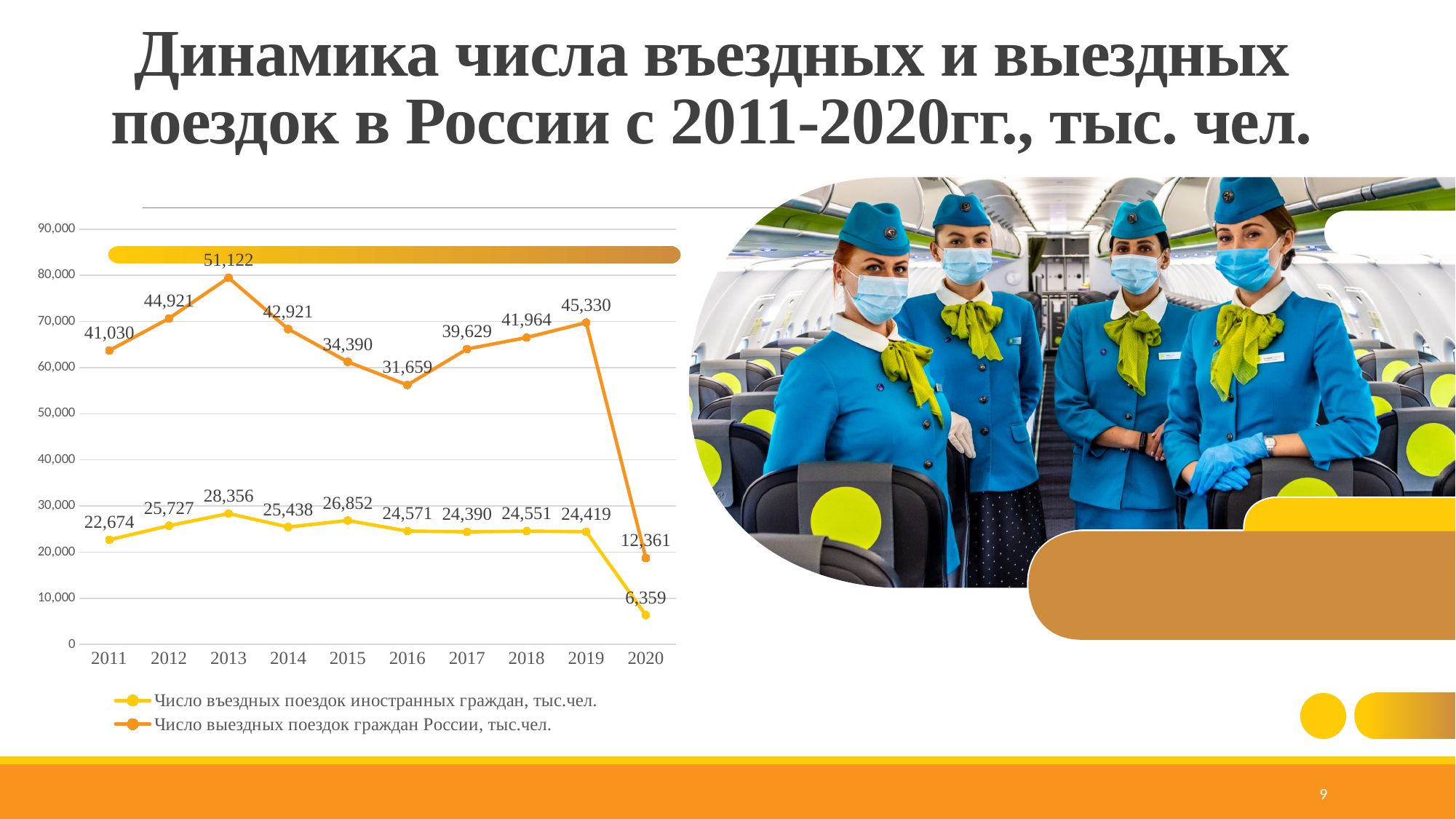
What is the value for outbound trips of Russian citizens in 2016? 31,659 What is the value for inbound trips of foreign citizens in 2020? 6,359 What is the value for inbound trips of foreign citizens (Число въездных поездок иностранных граждан) in 2011? 22,674 How many years are shown on the x axis of the chart? 10 How many series does the legend list? 2 In which year is the number of outbound trips of Russian citizens highest? 2013 Which is larger in 2019: outbound trips of Russian citizens or inbound trips of foreign citizens? Outbound trips of Russian citizens What is the difference between outbound trips of Russian citizens and inbound trips of foreign citizens in 2013? 22,766 What is the value for outbound trips of Russian citizens (Число выездных поездок граждан России) in 2013? 51,122 What kind of chart is shown on the slide? Line chart In which year is the number of inbound trips of foreign citizens lowest? 2020 What is the difference between outbound trips of Russian citizens and inbound trips of foreign citizens in 2020? 6,002